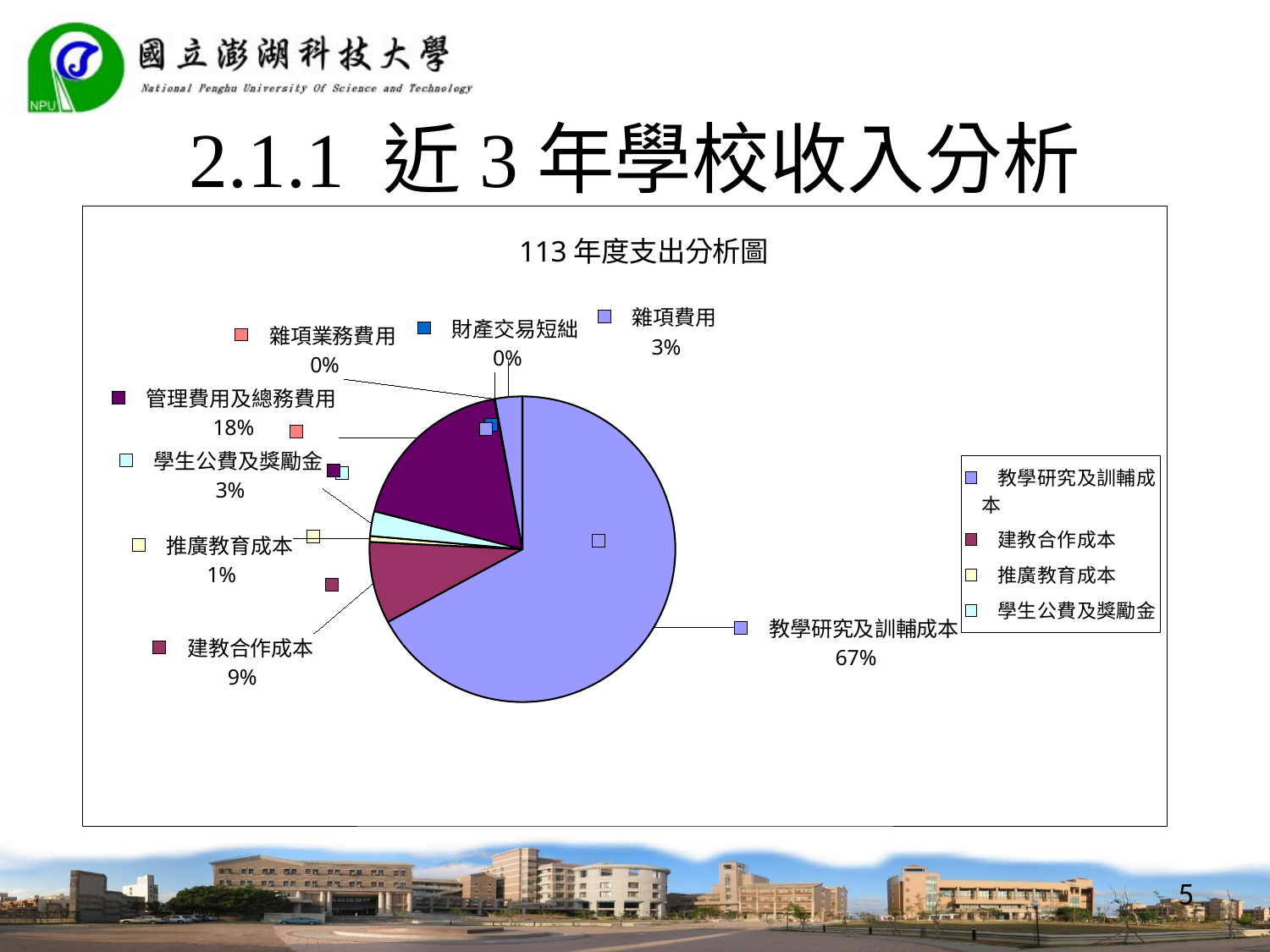
What percentage is shown for 財產交易短絀? 0% What share of the pie does 教學研究及訓輔成本 represent? 67% How many categories are labelled on the pie chart? 8 What percentage is shown for 推廣教育成本? 1% What percentage is shown for 管理費用及總務費用? 18% Which is larger, the share for 建教合作成本 or the share for 雜項費用? 建教合作成本 What percentage is shown for 建教合作成本? 9% What is the difference in percentage points between 教學研究及訓輔成本 and 管理費用及總務費用? 49 What percentage is shown for 學生公費及獎勵金? 3% What is the title of the chart? 113 年度支出分析圖 Which category has the largest share of the pie? 教學研究及訓輔成本 What kind of chart is shown on the slide? pie chart